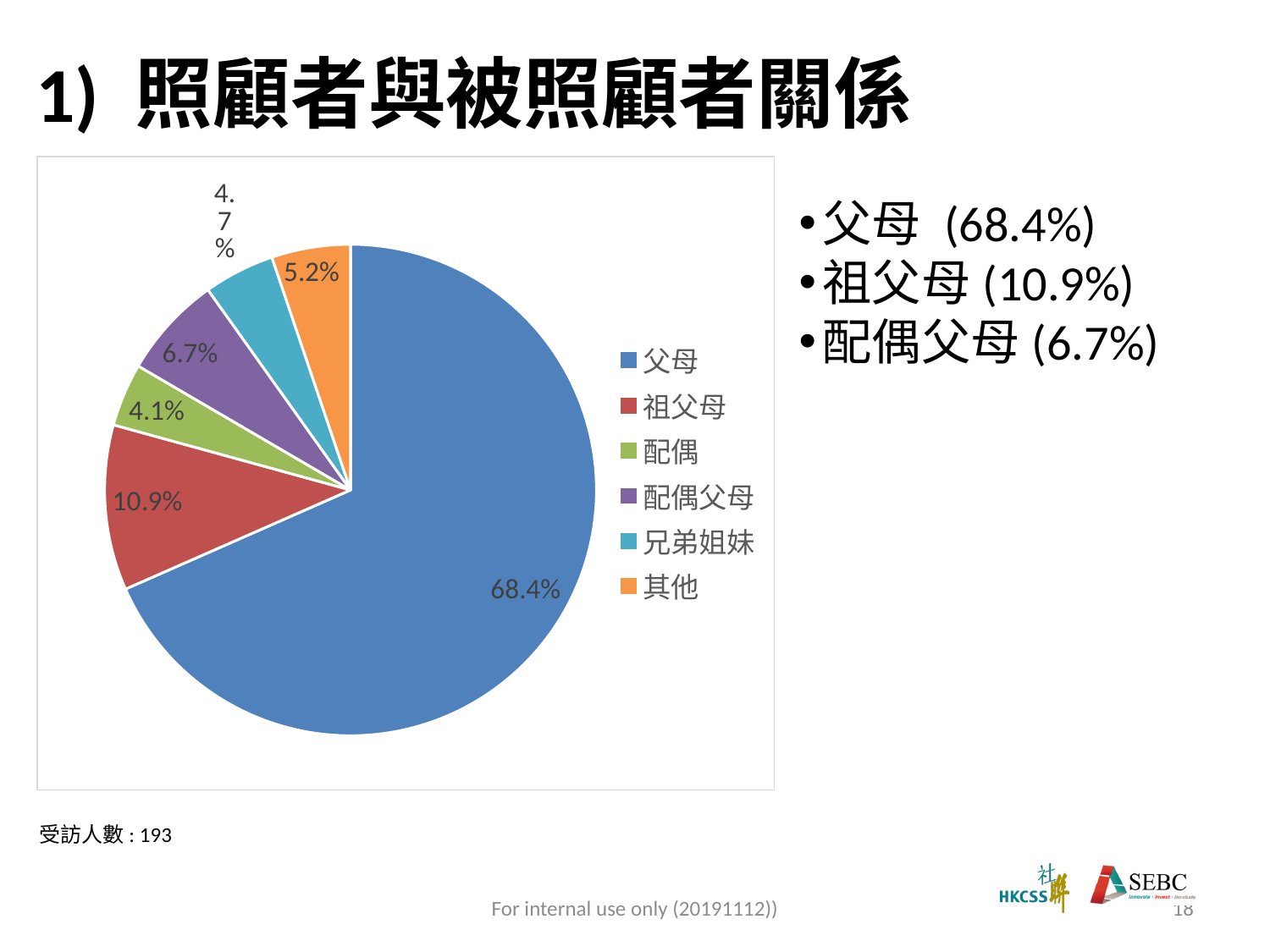
What colour is the slice for 祖父母? red What kind of chart is shown on the slide? pie chart What is the value shown for 其他? 5.2% What share of the pie does 父母 account for? 68.4% What is the difference between the values for 父母 and 祖父母? 57.5% Which category has the largest slice of the pie? 父母 What is the value shown for 配偶父母? 6.7% How many categories does the legend list? 6 What is the value shown for 祖父母? 10.9% Which category has the smallest slice of the pie? 配偶 Which is larger, the value for 兄弟姐妹 or the value for 其他? 其他 What is the value shown for 配偶? 4.1%